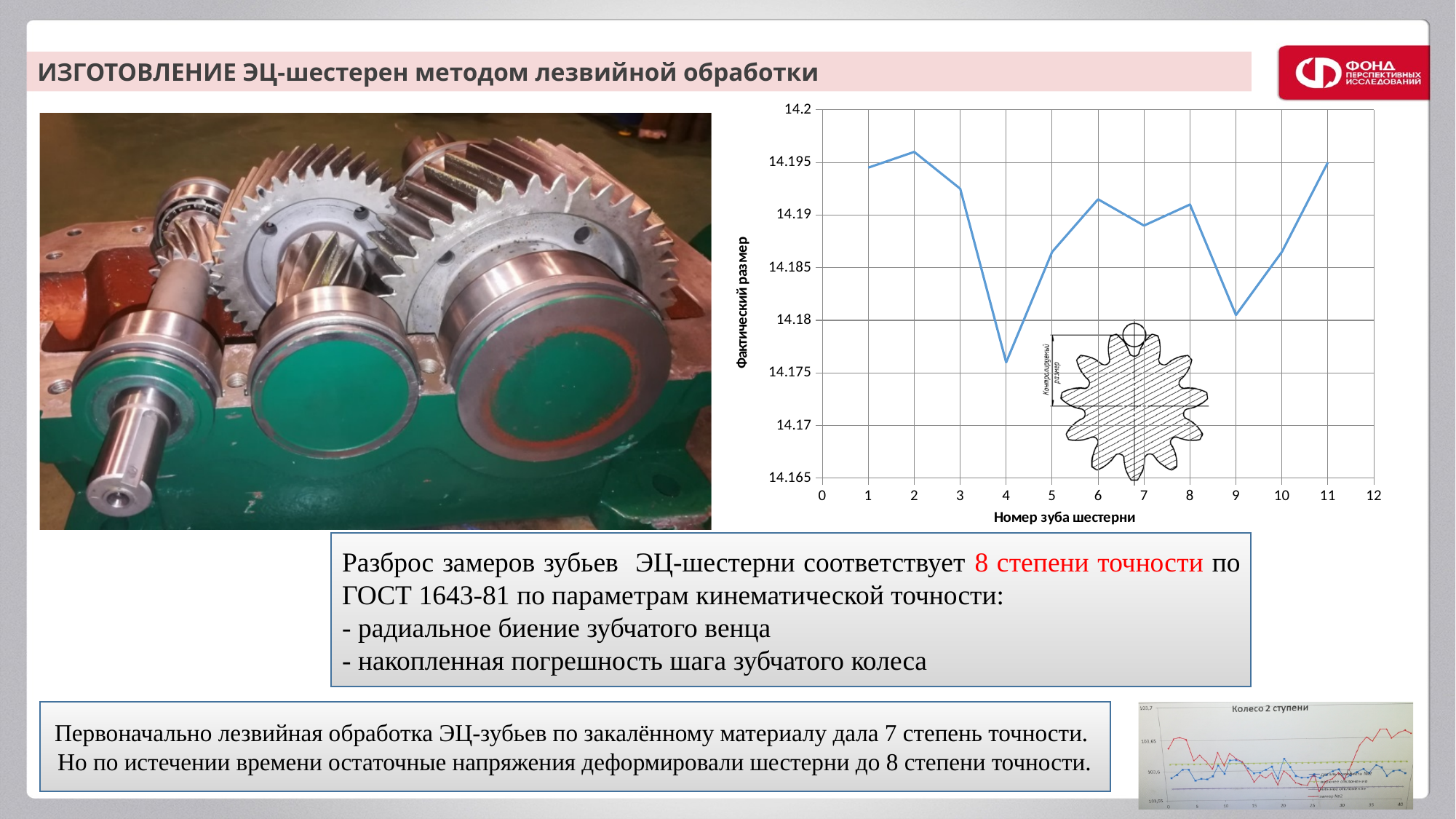
What is the y-axis title of the large line chart? Фактический размер In the large line chart, how many tooth numbers (data points) are plotted? 11 In the large line chart, is the value for tooth 1 greater or less than 14.19? greater In the large line chart, is the value for tooth 4 greater or less than 14.18? less In the large line chart, does the value rise or fall from tooth 2 to tooth 4? fall In the large line chart, does the value rise or fall from tooth 9 to tooth 11? rise In the large line chart, is the value for tooth 3 greater or less than 14.19? greater In the large line chart, which has the larger value: tooth 3 or tooth 5? tooth 3 In the large line chart, which has the larger value: tooth 4 or tooth 9? tooth 9 In the large line chart, which tooth number has the lowest 'Фактический размер'? 4 What kind of chart is the large chart with x axis 'Номер зуба шестерни'? line chart